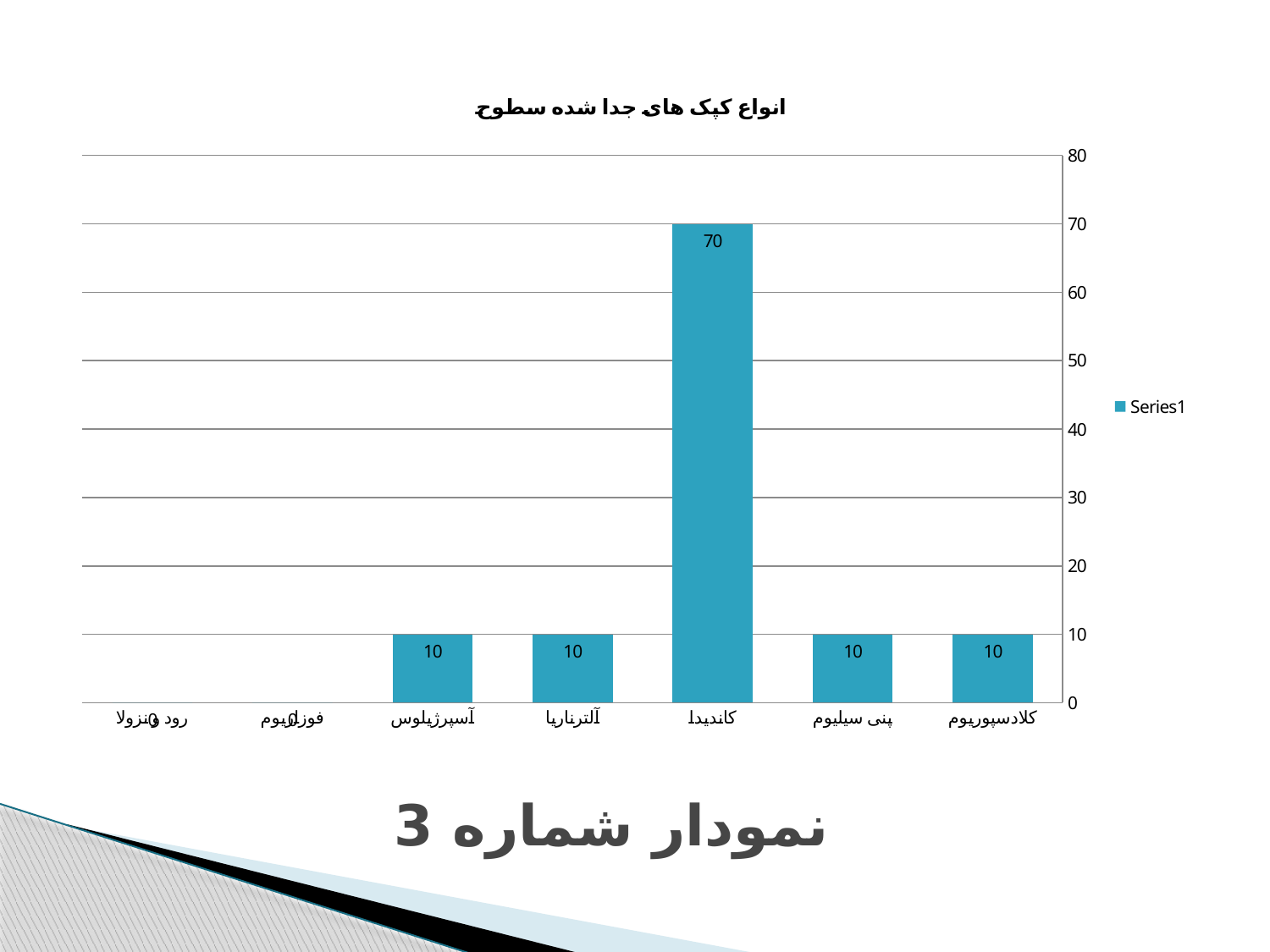
What is the value for پنی سیلیوم? 10 What is the value for آسپرژیلوس? 10 Is the value for کاندیدا greater or less than 60? greater What is the difference between the values for کاندیدا and آلترناریا? 60 What kind of chart is shown on the slide? bar chart What is the value for کلادسپوریوم? 10 How many series does the legend list? 1 What is the title of the chart? انواع کپک های جدا شده سطوح How many categories are shown on the x axis? 7 Which is larger, the value for کاندیدا or the value for پنی سیلیوم? کاندیدا Which category has the highest value? کاندیدا What is the value for کاندیدا? 70